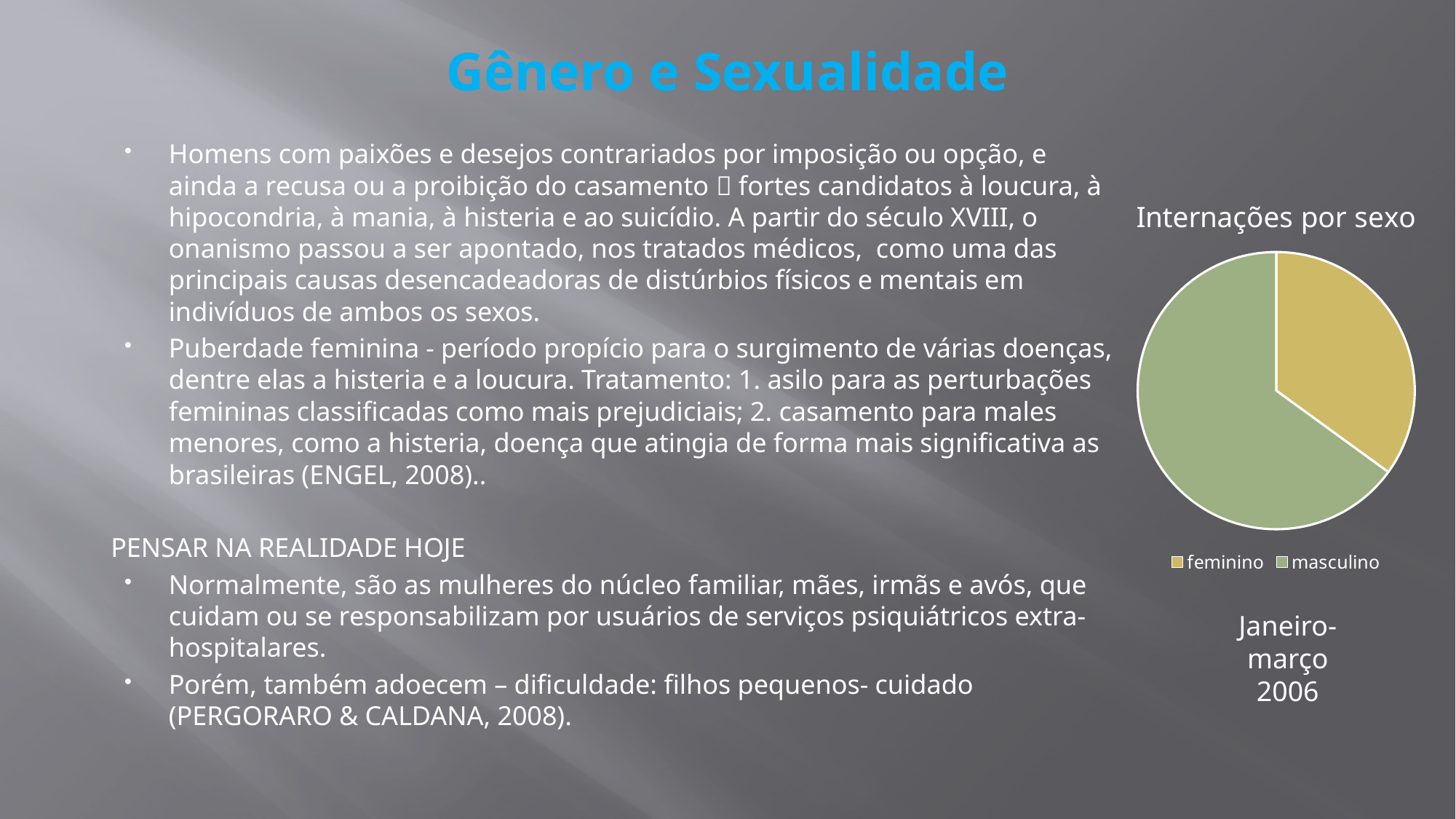
What is the title of the chart on the slide? Internações por sexo What period does the text below the pie chart say the data covers? Janeiro-março 2006 What kind of chart is shown on the slide? pie chart Which category has the smallest slice in the pie chart? feminino What colour is the masculino slice in the pie chart? green Which category has the largest slice in the pie chart? masculino Which slice is larger in the pie chart, feminino or masculino? masculino How many slices does the pie chart have? 2 How many entries does the legend of the pie chart list? 2